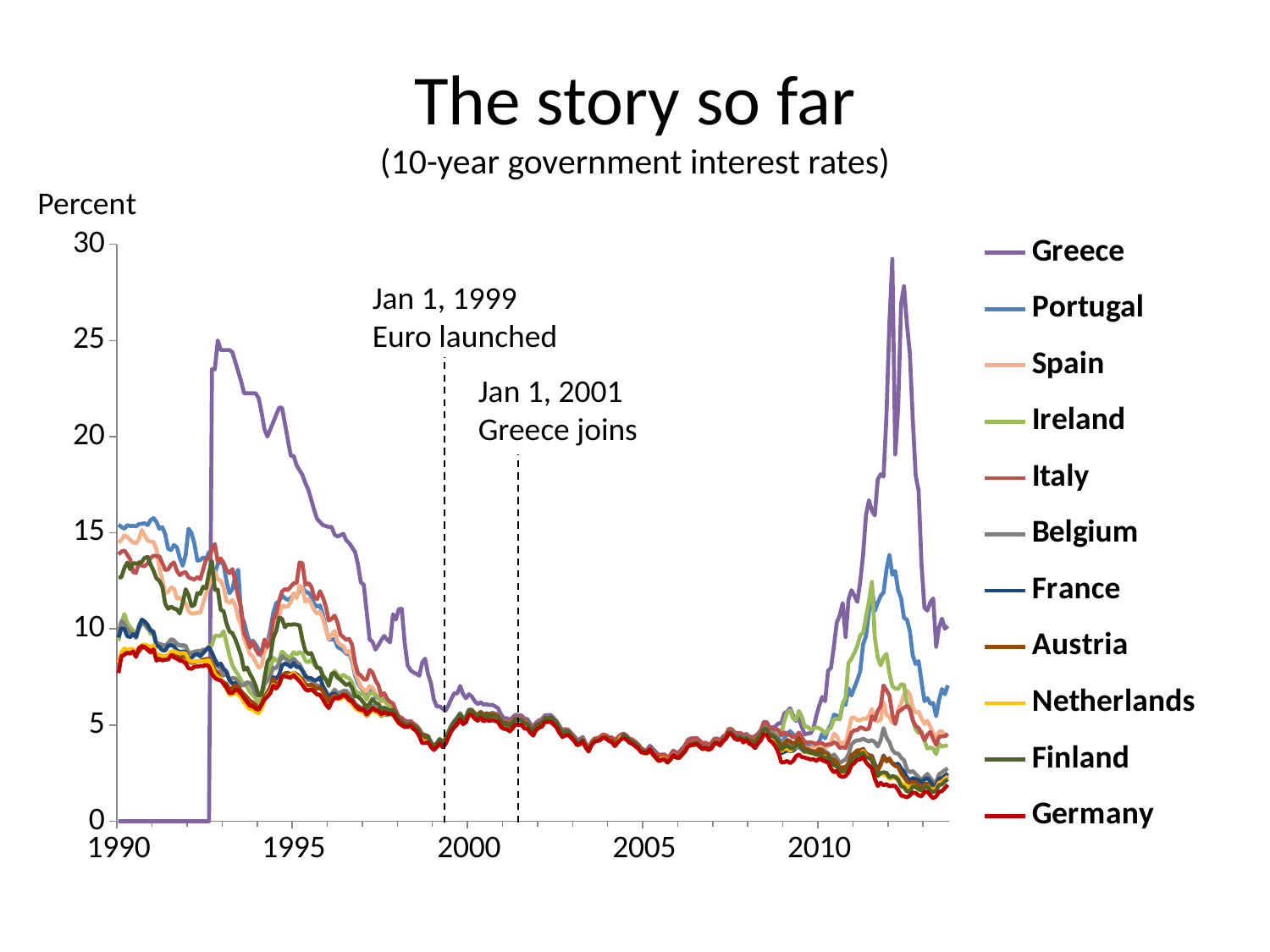
Is the value for Germany at the end of the series (around 2013) greater or less than 5? less Does the value for Greece rise or fall between 2010 and its peak around 2012? rise Is the value for Greece in 1993 greater or less than 20? greater What is the label on the vertical axis of the chart? Percent What kind of chart is shown on the slide? line chart How many series does the legend list? 11 Around 2012, which is larger: the value for Greece or the value for Germany? Greece According to the annotation on the chart, on what date was the Euro launched? Jan 1, 1999 Which country's line reaches the highest value on the chart? Greece In 1990, which is larger: the value for Portugal or the value for Germany? Portugal Does the value for Germany rise or fall overall from 1990 to the end of the series? fall Is the peak value for Greece around 2012 greater or less than 25? greater